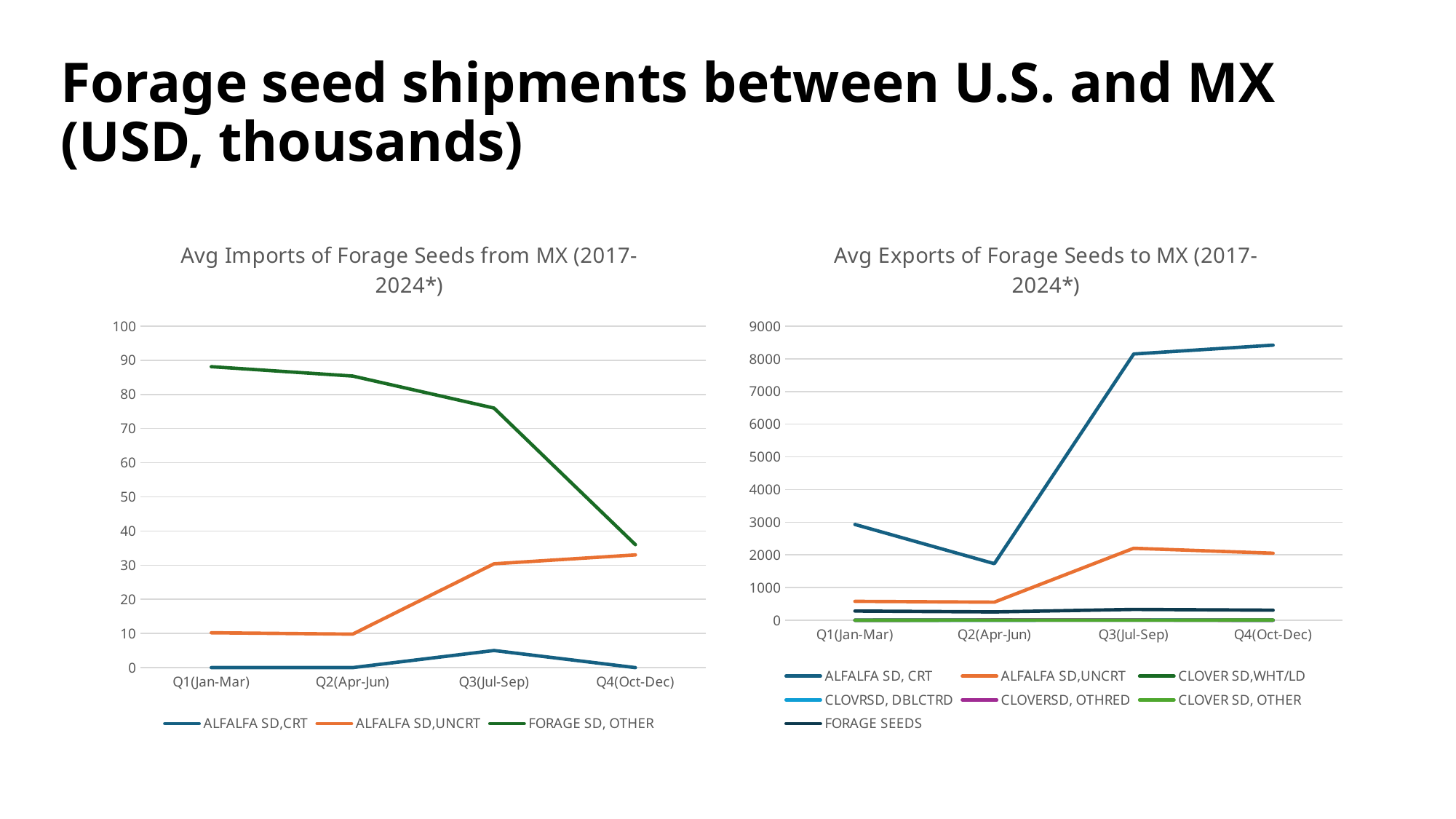
In the 'Avg Exports of Forage Seeds to MX (2017-2024*)' chart, which is larger in Q3(Jul-Sep): ALFALFA SD, CRT or ALFALFA SD,UNCRT? ALFALFA SD, CRT How many quarters are shown on the x axis of the 'Avg Exports of Forage Seeds to MX (2017-2024*)' chart? 4 In the 'Avg Imports of Forage Seeds from MX (2017-2024*)' chart, is the value for FORAGE SD, OTHER in Q4(Oct-Dec) greater or less than 40? less What is the title of the chart on the right side of the slide? Avg Exports of Forage Seeds to MX (2017-2024*) In the 'Avg Exports of Forage Seeds to MX (2017-2024*)' chart, in which quarter is ALFALFA SD, CRT lowest? Q2(Apr-Jun) In the 'Avg Imports of Forage Seeds from MX (2017-2024*)' chart, which series has the highest value in Q1(Jan-Mar)? FORAGE SD, OTHER In the 'Avg Exports of Forage Seeds to MX (2017-2024*)' chart, is the value for ALFALFA SD, CRT in Q3(Jul-Sep) greater or less than 7000? greater What kind of chart is the 'Avg Imports of Forage Seeds from MX (2017-2024*)' chart? Line chart In the 'Avg Imports of Forage Seeds from MX (2017-2024*)' chart, is the value for FORAGE SD, OTHER in Q1(Jan-Mar) greater or less than 80? greater How many series does the legend of the 'Avg Imports of Forage Seeds from MX (2017-2024*)' chart list? 3 In the 'Avg Imports of Forage Seeds from MX (2017-2024*)' chart, does the FORAGE SD, OTHER line rise or fall from Q1(Jan-Mar) to Q4(Oct-Dec)? Fall How many series does the legend of the 'Avg Exports of Forage Seeds to MX (2017-2024*)' chart list? 7